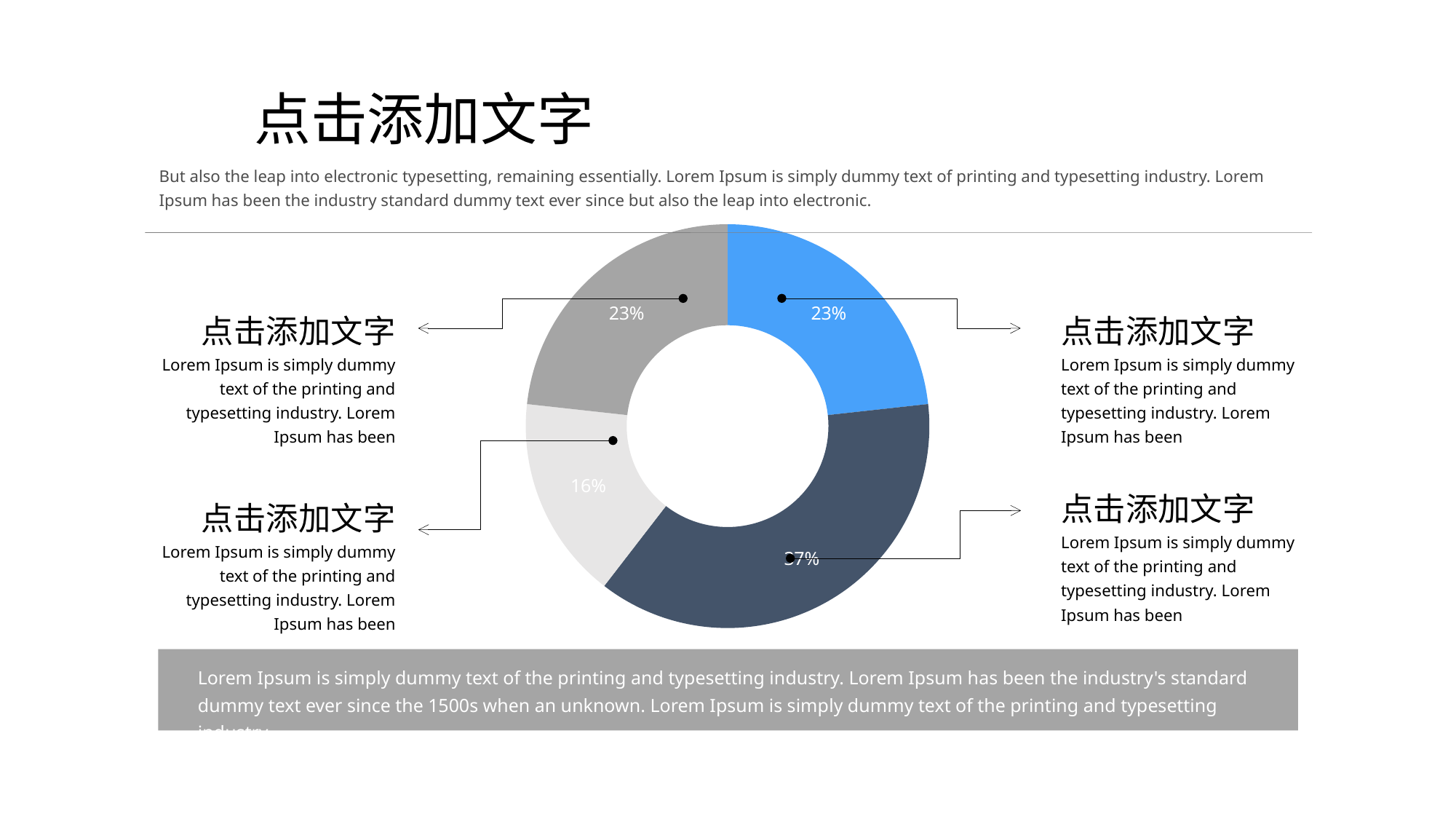
Which slice of the doughnut chart is the largest? the dark navy slice What kind of chart is shown on the slide? doughnut chart What value is printed on the light gray slice of the doughnut chart? 16% What is the difference between the blue slice (23%) and the light gray slice (16%) in the doughnut chart? 7% Is the value of the dark navy slice in the doughnut chart greater or less than 30%? greater Which is larger in the doughnut chart, the blue slice or the light gray slice? the blue slice What value is printed on the blue slice of the doughnut chart? 23% Which slice of the doughnut chart is the smallest? the light gray slice (16%) What value is printed on the medium gray slice at the top left of the doughnut chart? 23% What colour is the slice labelled 16% in the doughnut chart? light gray How many slices does the doughnut chart have? 4 Does the doughnut chart have a legend? No